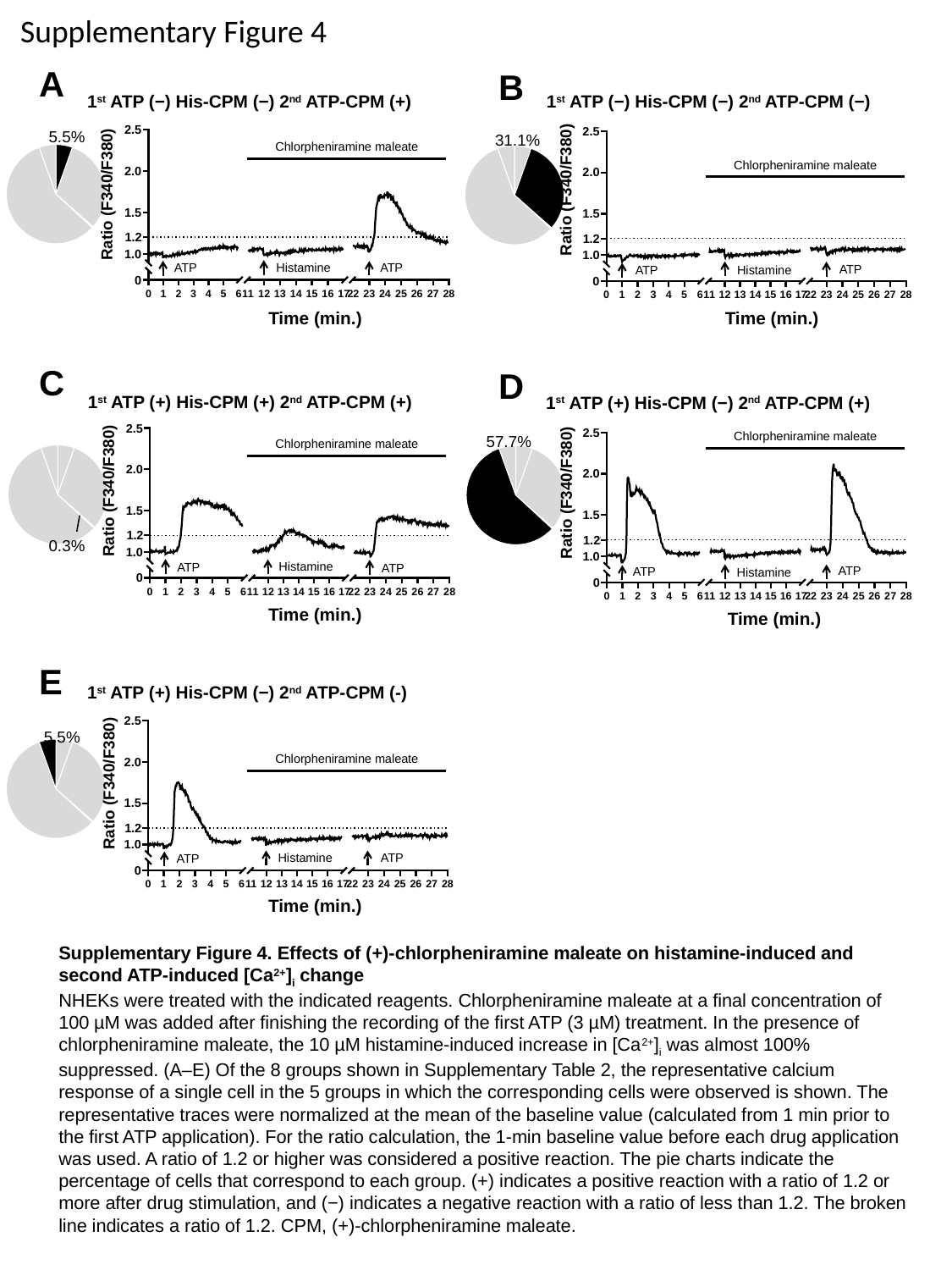
Which panel's pie chart shows the smallest labelled percentage? C Is the labelled pie percentage in panel B larger or smaller than that in panel A? larger What is the difference between the labelled pie percentages in panel D and panel B? 26.6% In panel D, is the peak ratio after the second ATP application greater or less than 2.0? greater What is the label of the x axis on the line charts? Time (min.) Which panel's pie chart shows the largest labelled percentage? D In panel B, what percentage is labelled on the pie chart? 31.1% In panel C, what percentage is labelled on the pie chart? 0.3% In panel A, what percentage is labelled on the pie chart? 5.5% What kind of chart shows the Ratio (F340/F380) over time in each panel? line chart In panel D, what percentage is labelled on the pie chart? 57.7% In panel A, is the peak ratio after the second ATP application greater or less than 1.5? greater